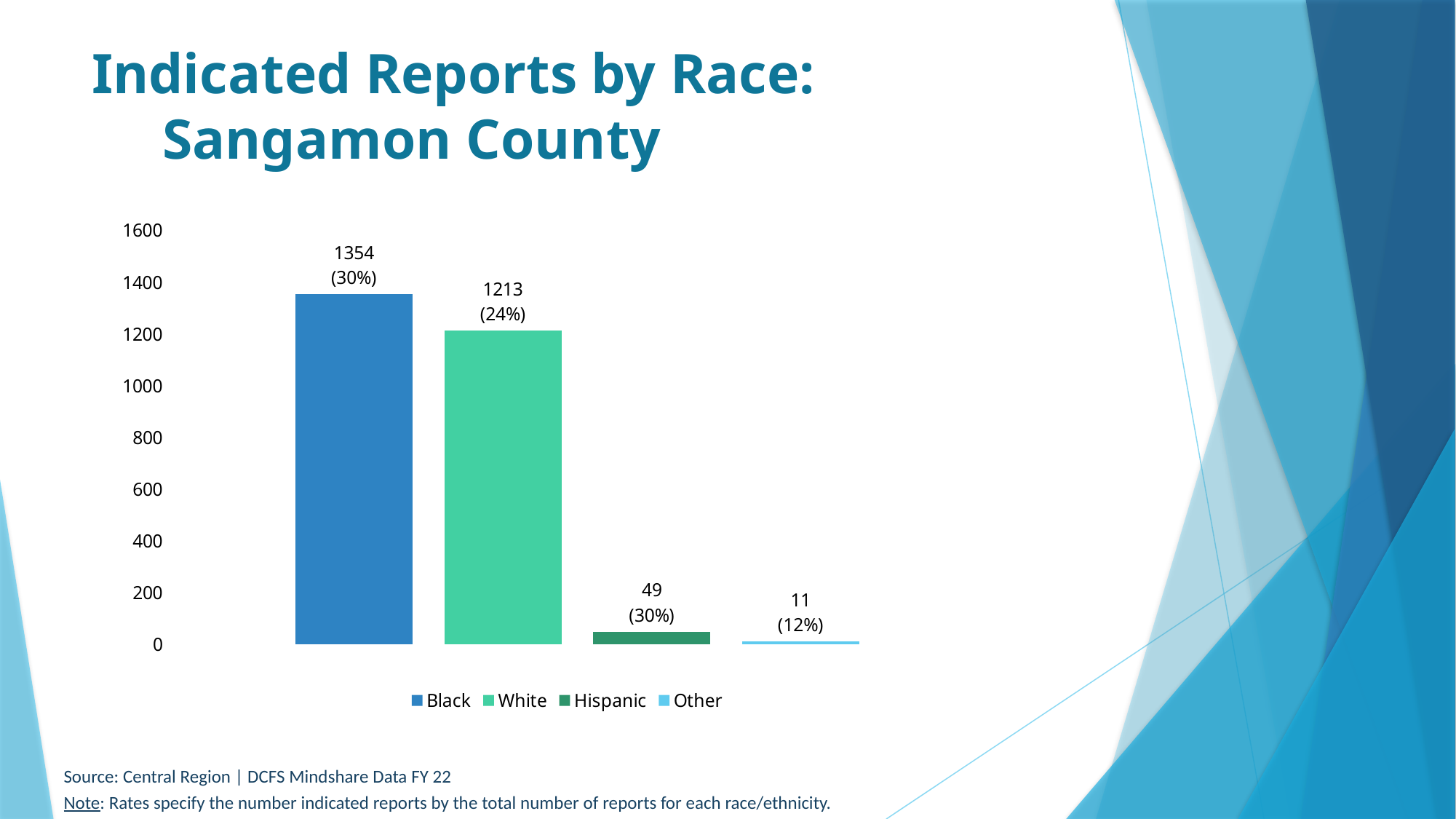
How many indicated reports are shown for Black? 1354 How many categories does the legend list? 4 What percentage is shown for Other? 12% Which category has the lowest number of indicated reports? Other How many indicated reports are shown for White? 1213 Which category has the highest number of indicated reports? Black Is the value for White greater or less than 1000? greater What kind of chart is shown on the slide? Bar chart What is the difference between the number of indicated reports for Black and White? 141 Which has more indicated reports, Hispanic or Other? Hispanic What is the title of the slide? Indicated Reports by Race: Sangamon County How many indicated reports are shown for Hispanic? 49